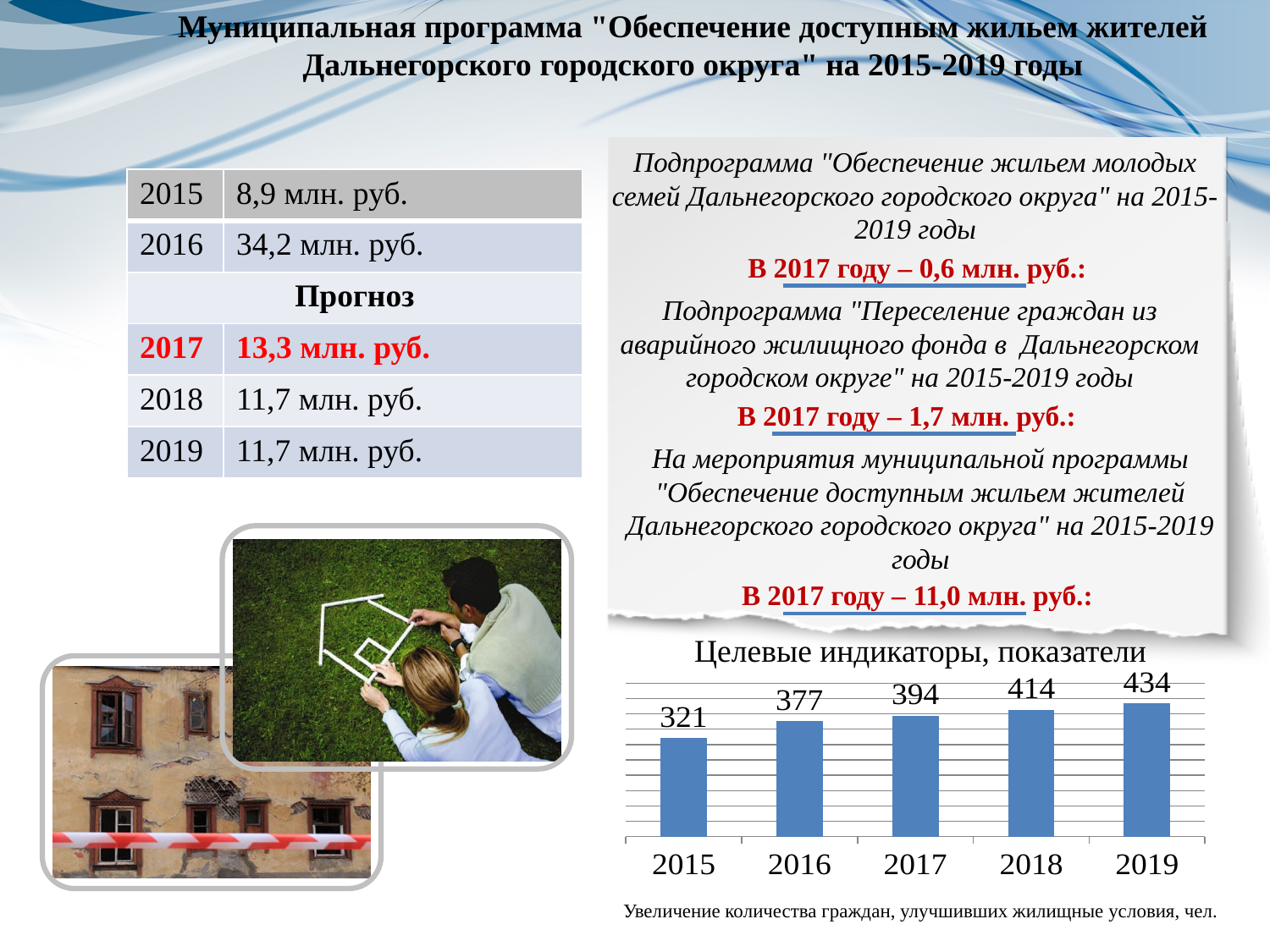
Which year has the lowest value in the chart 'Целевые индикаторы, показатели'? 2015 What is the difference between the values for 2019 and 2015 in the chart 'Целевые индикаторы, показатели'? 113 Which year has the highest value in the chart 'Целевые индикаторы, показатели'? 2019 In the chart 'Целевые индикаторы, показатели', which is larger: the value for 2018 or the value for 2016? 2018 What is the difference between the values for 2016 and 2015 in the chart 'Целевые индикаторы, показатели'? 56 What is the value for 2015 in the chart 'Целевые индикаторы, показатели'? 321 Do the values in the chart 'Целевые индикаторы, показатели' rise or fall from 2015 to 2019? rise What is the value for 2019 in the chart 'Целевые индикаторы, показатели'? 434 How many years are shown on the x axis of the chart 'Целевые индикаторы, показатели'? 5 What is the value for 2017 in the chart 'Целевые индикаторы, показатели'? 394 What is the title of the chart on the slide? Целевые индикаторы, показатели What kind of chart is 'Целевые индикаторы, показатели'? bar chart